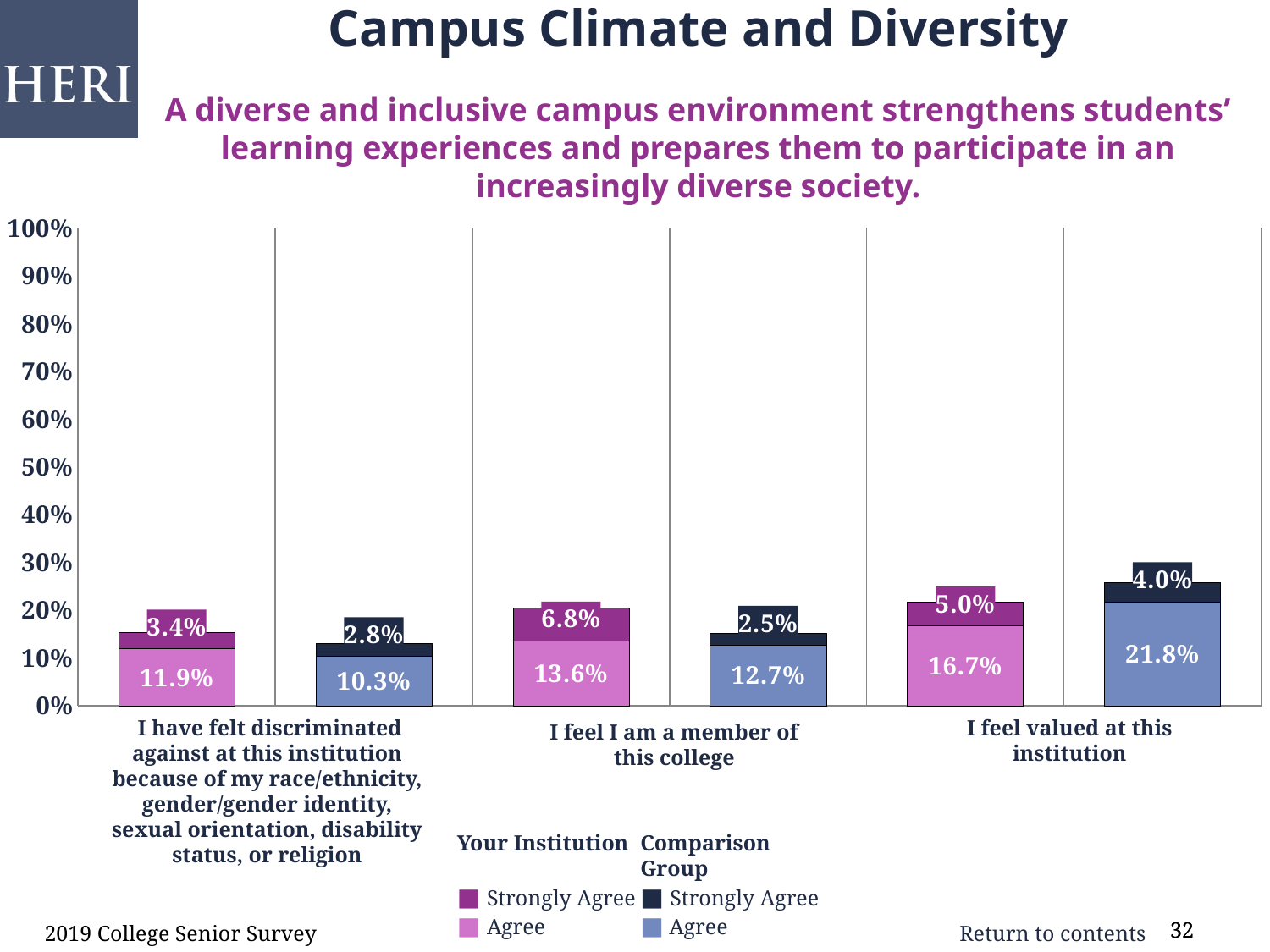
What is the total of the Comparison Group stacked bar (Agree plus Strongly Agree) for "I feel valued at this institution"? 25.8% What percentage of the Comparison Group selected Strongly Agree for "I feel I am a member of this college"? 2.5% How many survey items (categories) are shown on the x axis of the chart? 3 What is the total of the Your Institution stacked bar (Agree plus Strongly Agree) for "I feel I am a member of this college"? 20.4% Which survey item has the highest Strongly Agree value for Your Institution? I feel I am a member of this college For "I feel valued at this institution", which group has the larger Agree value, Your Institution or the Comparison Group? Comparison Group What percentage of students at Your Institution selected Agree for "I feel valued at this institution"? 16.7% How many series does the chart legend list? 4 What is the difference between the Your Institution Strongly Agree value and the Comparison Group Strongly Agree value for "I feel I am a member of this college"? 4.3% What percentage of students at Your Institution selected Agree for "I have felt discriminated against at this institution because of my race/ethnicity, gender/gender identity, sexual orientation, disability status, or religion"? 11.9% Which survey item has the lowest Agree value for the Comparison Group? I have felt discriminated against at this institution because of my race/ethnicity, gender/gender identity, sexual orientation, disability status, or religion What kind of chart is shown on the slide? Stacked bar chart